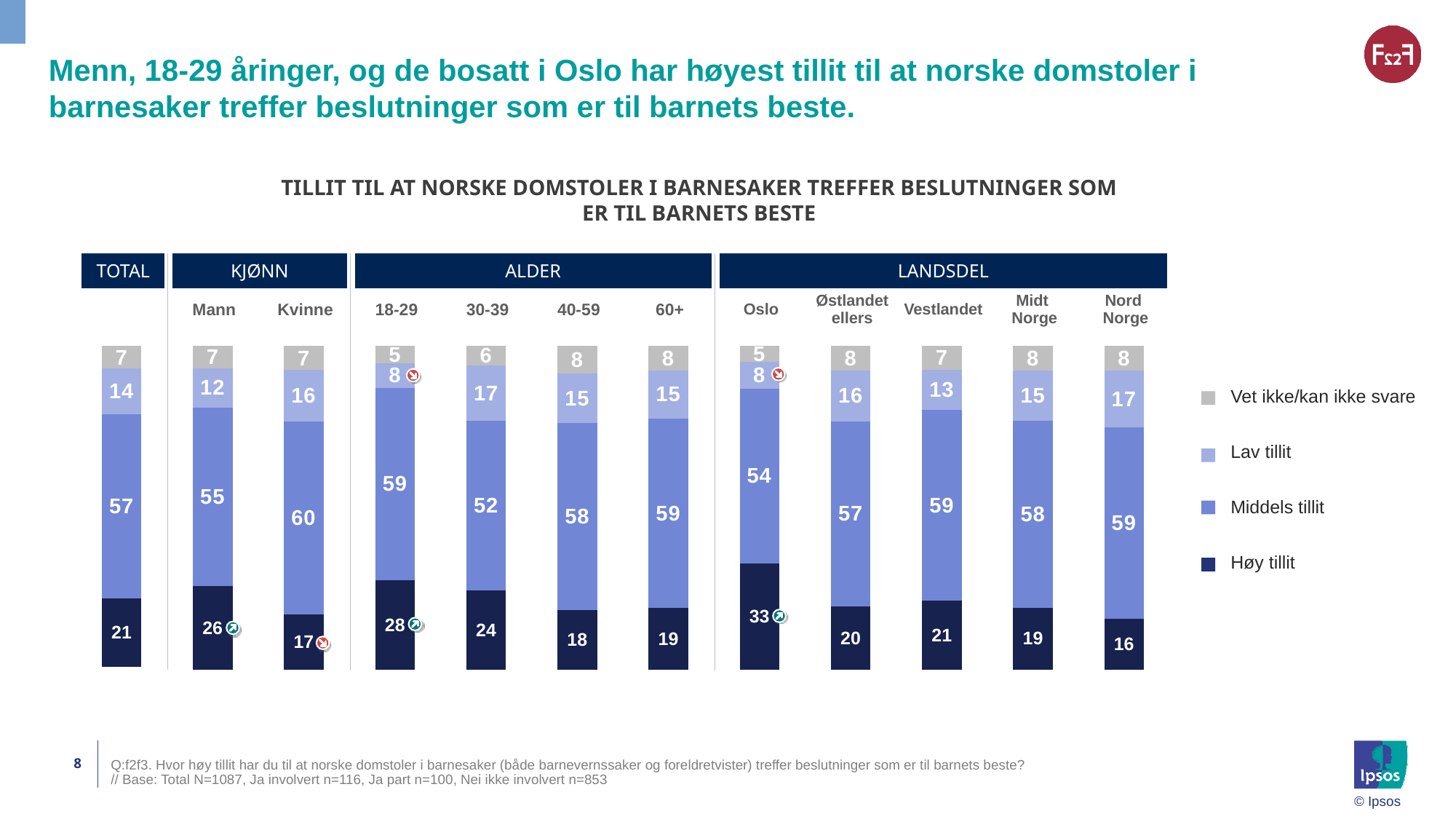
What is the difference between the Høy tillit values for Mann and Kvinne? 9 How many series does the legend list? 4 Which legend entry is shown in grey? Vet ikke/kan ikke svare Which has a larger Høy tillit value, 18-29 or 60+? 18-29 How many categories (bars) are shown in the chart? 12 What is the total of the stacked bar for TOTAL? 99 What is the value for Middels tillit for Kvinne? 60 What is the value for Lav tillit for the 30-39 age group? 17 Which category has the lowest value for Høy tillit? Nord Norge What is the value for Høy tillit in the TOTAL bar? 21 Which category has the highest value for Høy tillit? Oslo What kind of chart is shown on the slide? Stacked bar chart